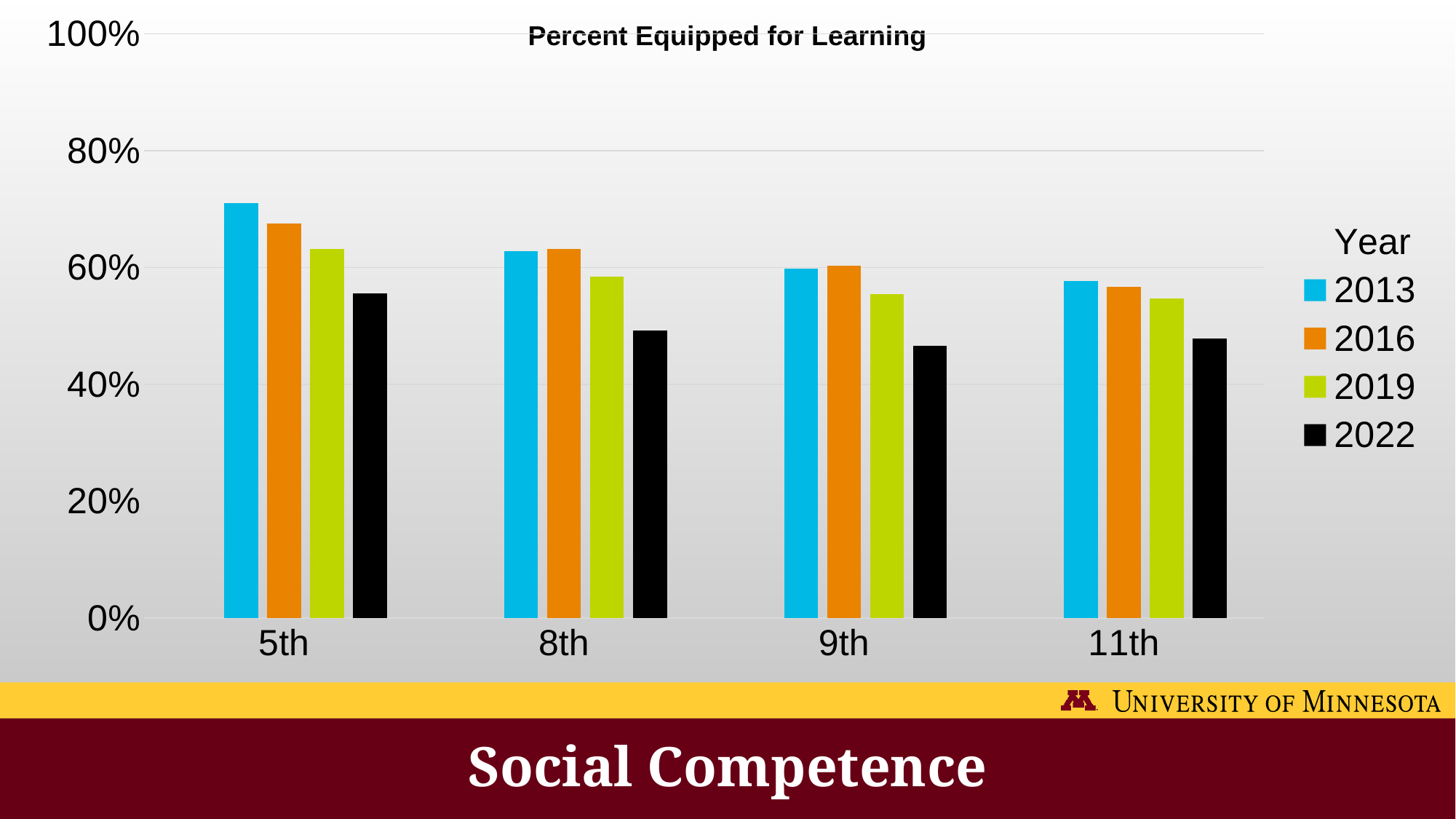
How many years does the legend list? 4 Is the value for 9th grade in 2022 greater or less than 40%? greater What kind of chart is shown on the slide? bar chart For 5th grade, do the values rise or fall from 2013 to 2022? fall What colour represents the year 2022 in the chart? black Which year has the highest value for 5th grade? 2013 Is the value for 5th grade in 2013 greater or less than 60%? greater How many grade categories are shown on the x axis? 4 Which year has the lowest value for 5th grade? 2022 What is the title of the chart? Percent Equipped for Learning Which is larger for 9th grade: the 2019 value or the 2022 value? 2019 Is the value for 8th grade in 2022 greater or less than 60%? less